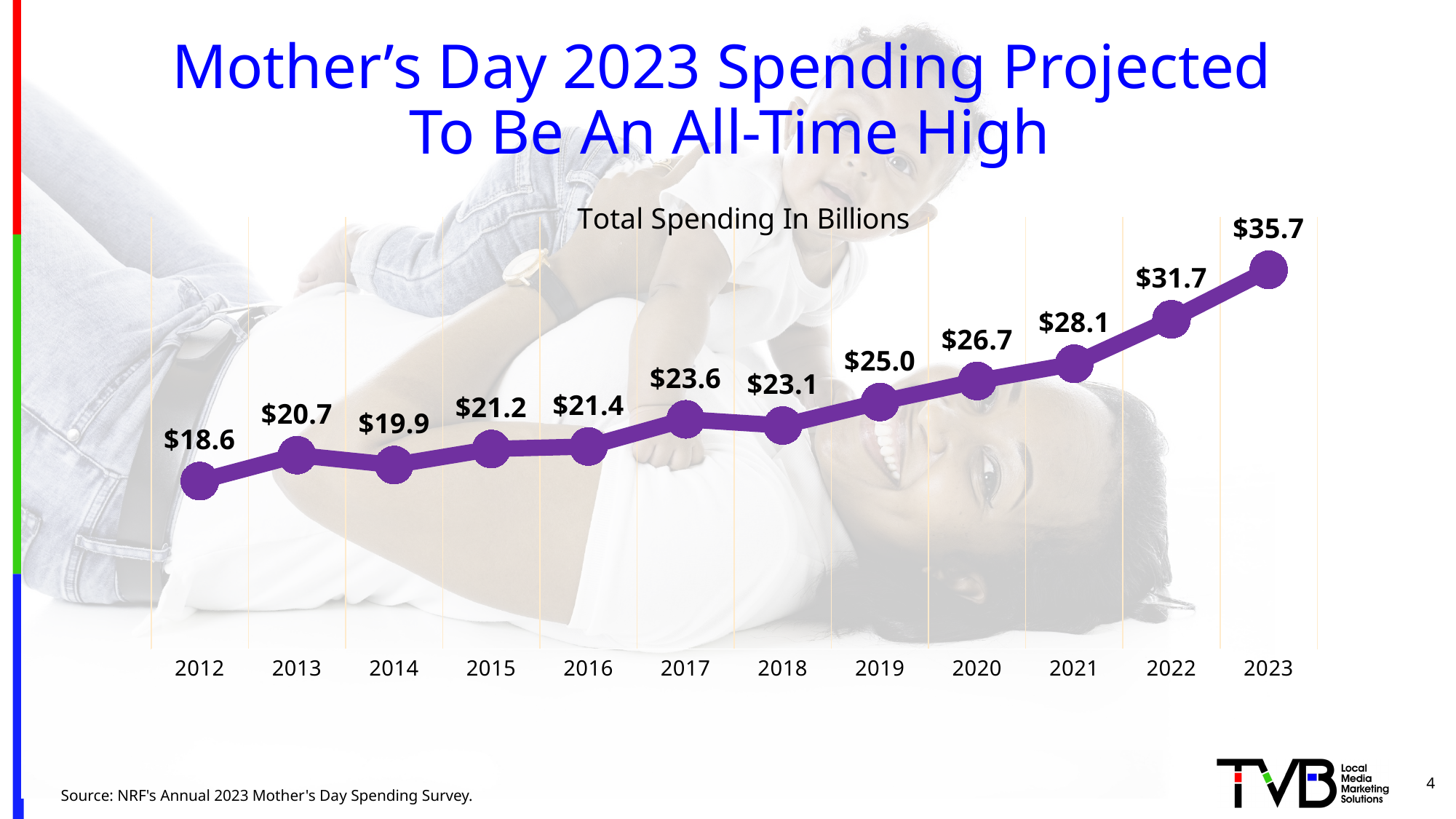
What colour is the line on the chart? Purple Do the values generally rise or fall from 2012 to 2023? Rise What is the title of the chart? Total Spending In Billions Which year has the larger value, 2017 or 2018? 2017 What is the difference between the 2023 value and the 2022 value? $4.0 What is the total spending value shown for 2012? $18.6 Which year has the lowest total spending? 2012 Which year has the highest total spending? 2023 What kind of chart is shown on the slide? Line chart How many years are plotted on the chart? 12 What is the total spending value shown for 2018? $23.1 What is the total spending value shown for 2023? $35.7